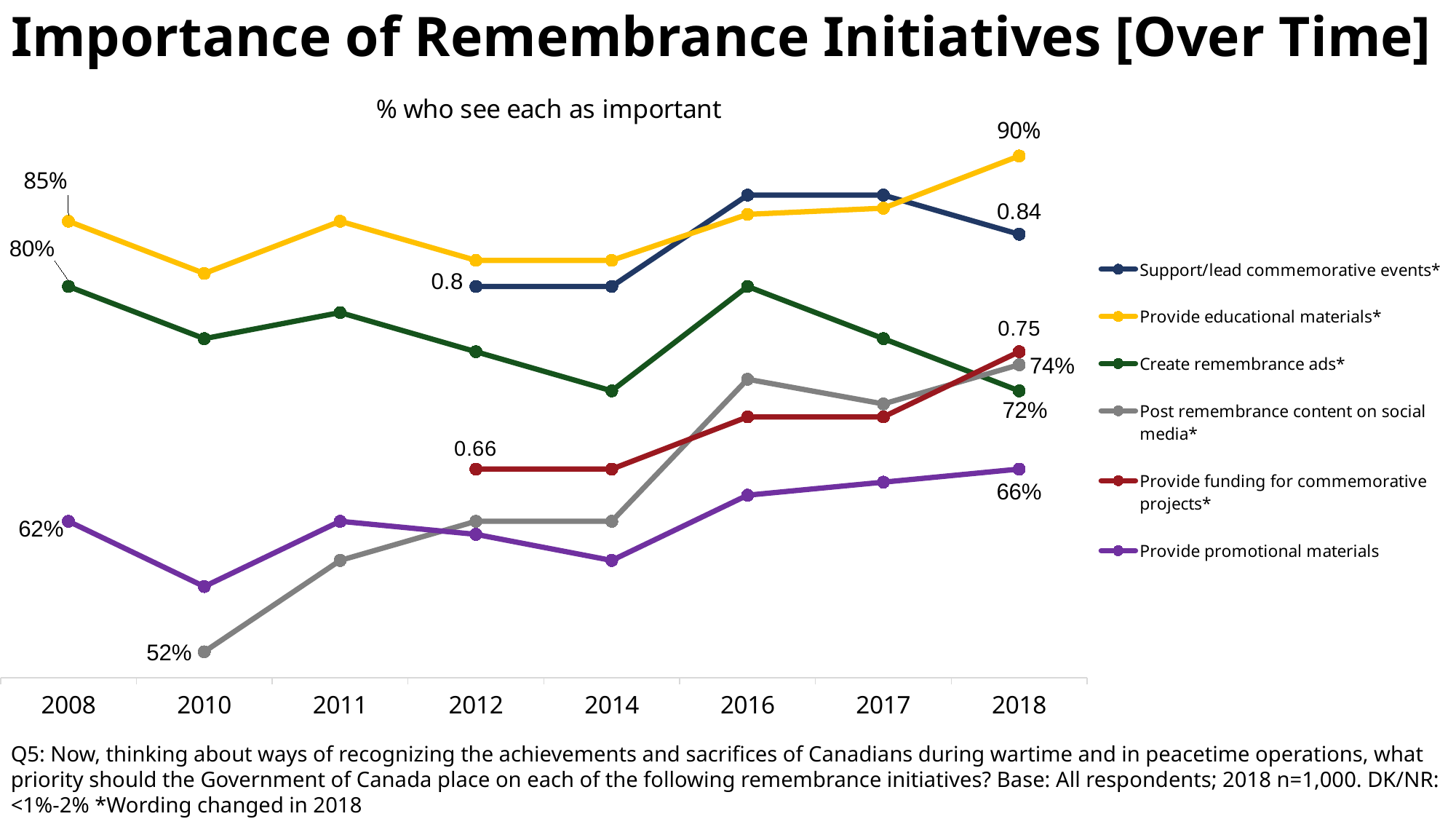
Which series has the highest value in 2018? Provide educational materials* What is the value for Post remembrance content on social media* in 2010? 52% Which series has the lowest value in 2018? Provide promotional materials How many series does the legend list? 6 What kind of chart is shown on the slide? Line chart What is the value for Provide educational materials* in 2018? 90% What is the value for Support/lead commemorative events* in 2012? 0.8 By how many percentage points did Post remembrance content on social media* change from 2010 to 2018? 22 percentage points How many years are shown on the x axis? 8 What is the value for Provide funding for commemorative projects* in 2018? 0.75 What is the value for Create remembrance ads* in 2008? 80% Which is larger in 2018: Provide educational materials* or Create remembrance ads*? Provide educational materials*